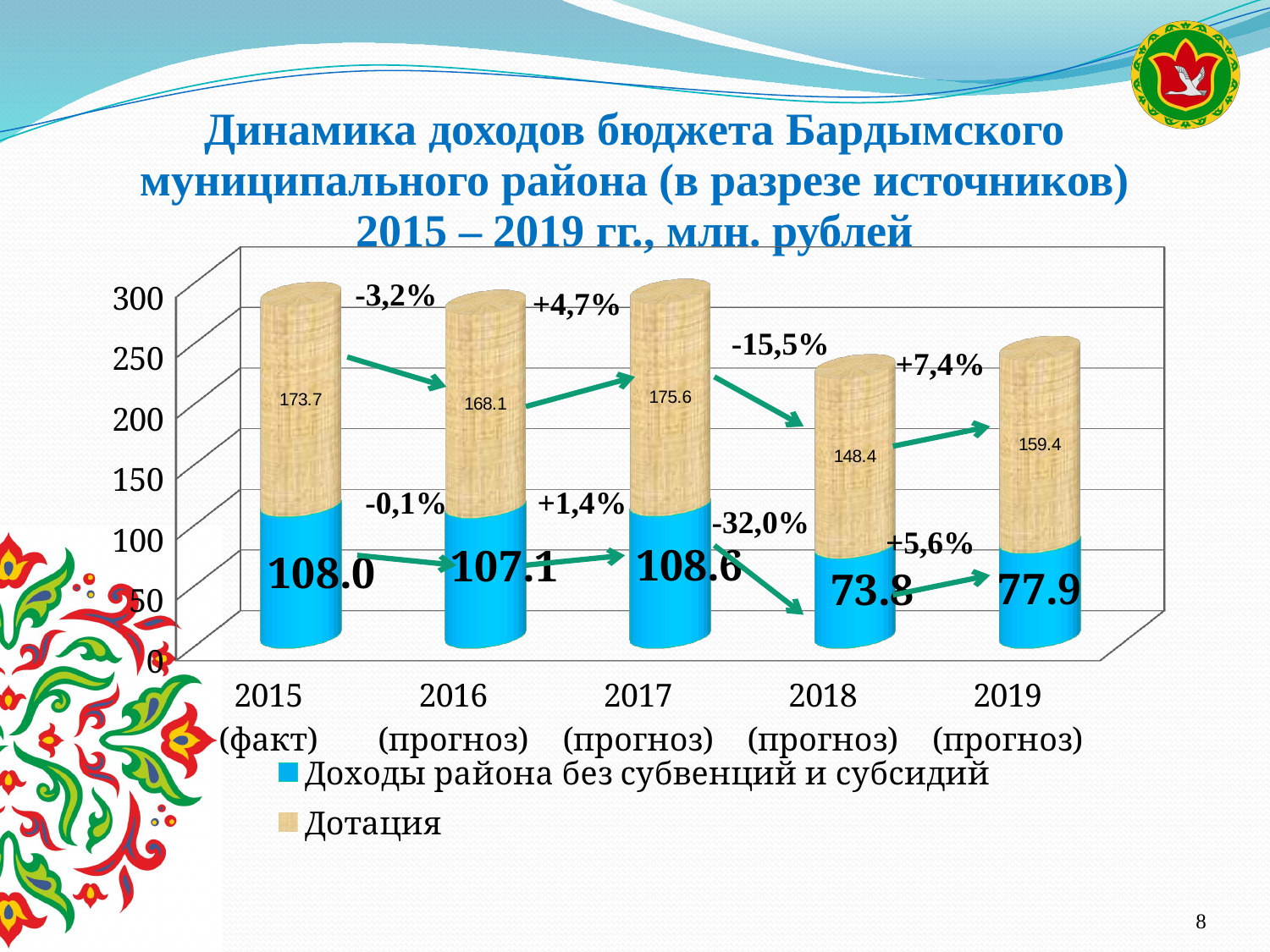
What is the total of the stacked bar for 2018? 222.2 How many series does the legend list? 2 Which year has the lowest value for Доходы района без субвенций и субсидий? 2018 What kind of chart is shown on the slide? Stacked bar chart What is the total of the stacked bar for 2015? 281.7 What is the difference between the Дотация values for 2017 and 2018? 27.2 Which is larger: Доходы района без субвенций и субсидий in 2015 or in 2019? 2015 What is the value of Доходы района без субвенций и субсидий for 2018? 73.8 What is the value of Дотация for 2019? 159.4 Which year has the highest value for Дотация? 2017 How many years are shown on the x axis? 5 What is the value of Дотация for 2017? 175.6